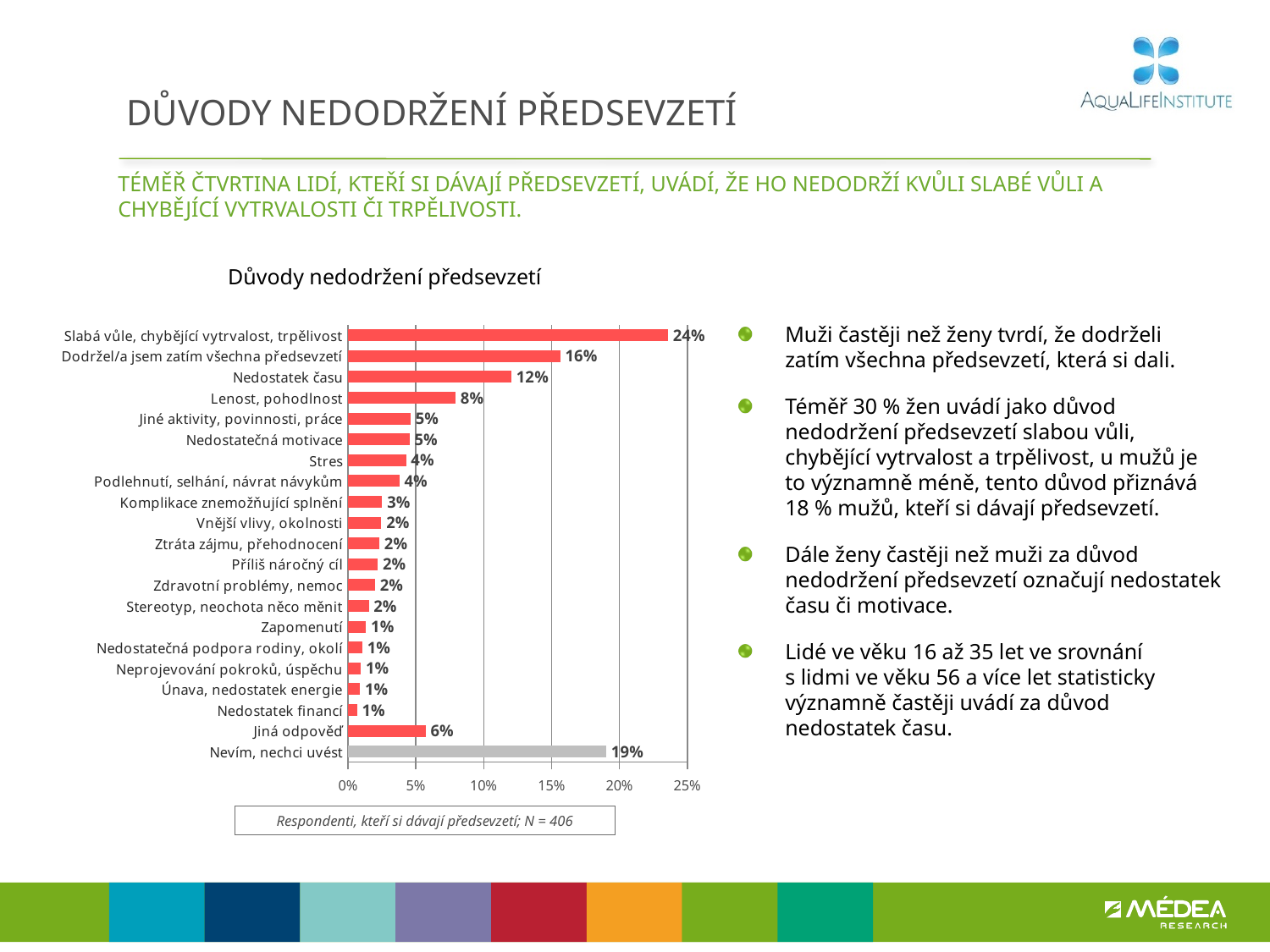
What is the value for "Nevím, nechci uvést"? 19% What type of chart is shown on the slide? bar chart Which category has the highest value in the chart? Slabá vůle, chybějící vytrvalost, trpělivost What is the value for "Nedostatek času"? 12% Which is larger, the value for "Nedostatek času" or the value for "Lenost, pohodlnost"? Nedostatek času What is the title of the chart? Důvody nedodržení předsevzetí Is the value for "Nevím, nechci uvést" greater or less than 15%? greater What is the value for "Jiná odpověď"? 6% What is the value for "Slabá vůle, chybějící vytrvalost, trpělivost"? 24% How many categories are shown in the chart? 21 Which category's bar is coloured grey instead of red? Nevím, nechci uvést What is the difference between the values for "Slabá vůle, chybějící vytrvalost, trpělivost" and "Dodržel/a jsem zatím všechna předsevzetí"? 8 percentage points